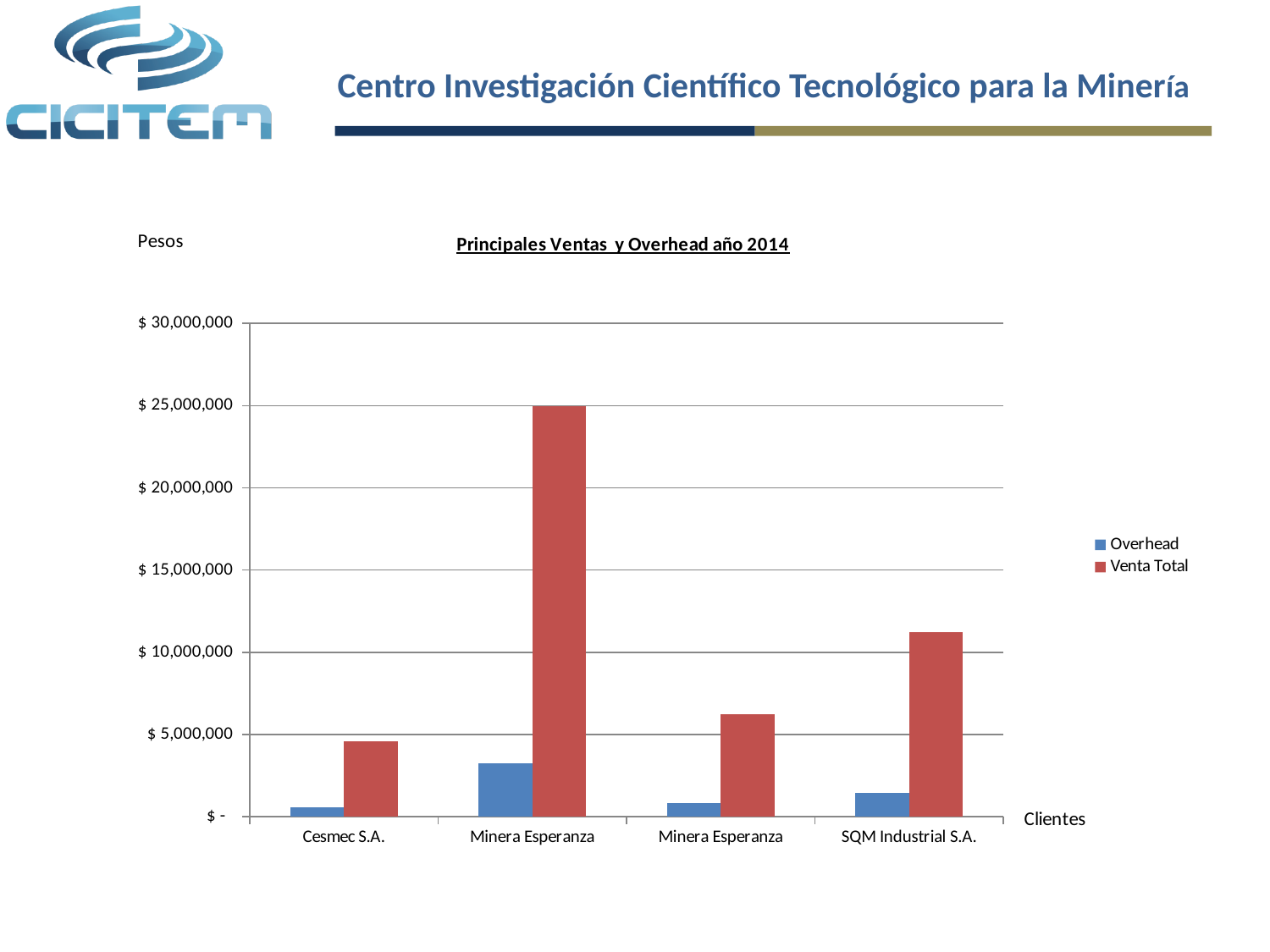
Which client has the lowest Venta Total? Cesmec S.A. What kind of chart is shown on the slide? bar chart What colour represents the Venta Total series in the legend? red How many client categories are shown on the x axis? 4 Is the Venta Total for SQM Industrial S.A. greater or less than $ 10,000,000? greater Is the Overhead for SQM Industrial S.A. greater or less than $ 5,000,000? less Which client has the highest Overhead? Minera Esperanza How many series does the legend list? 2 Which is larger, the Venta Total for SQM Industrial S.A. or the Venta Total for Cesmec S.A.? SQM Industrial S.A. Is the Venta Total for Cesmec S.A. greater or less than $ 5,000,000? less Which client has the highest Venta Total? Minera Esperanza What is the title of the chart? Principales Ventas y Overhead año 2014